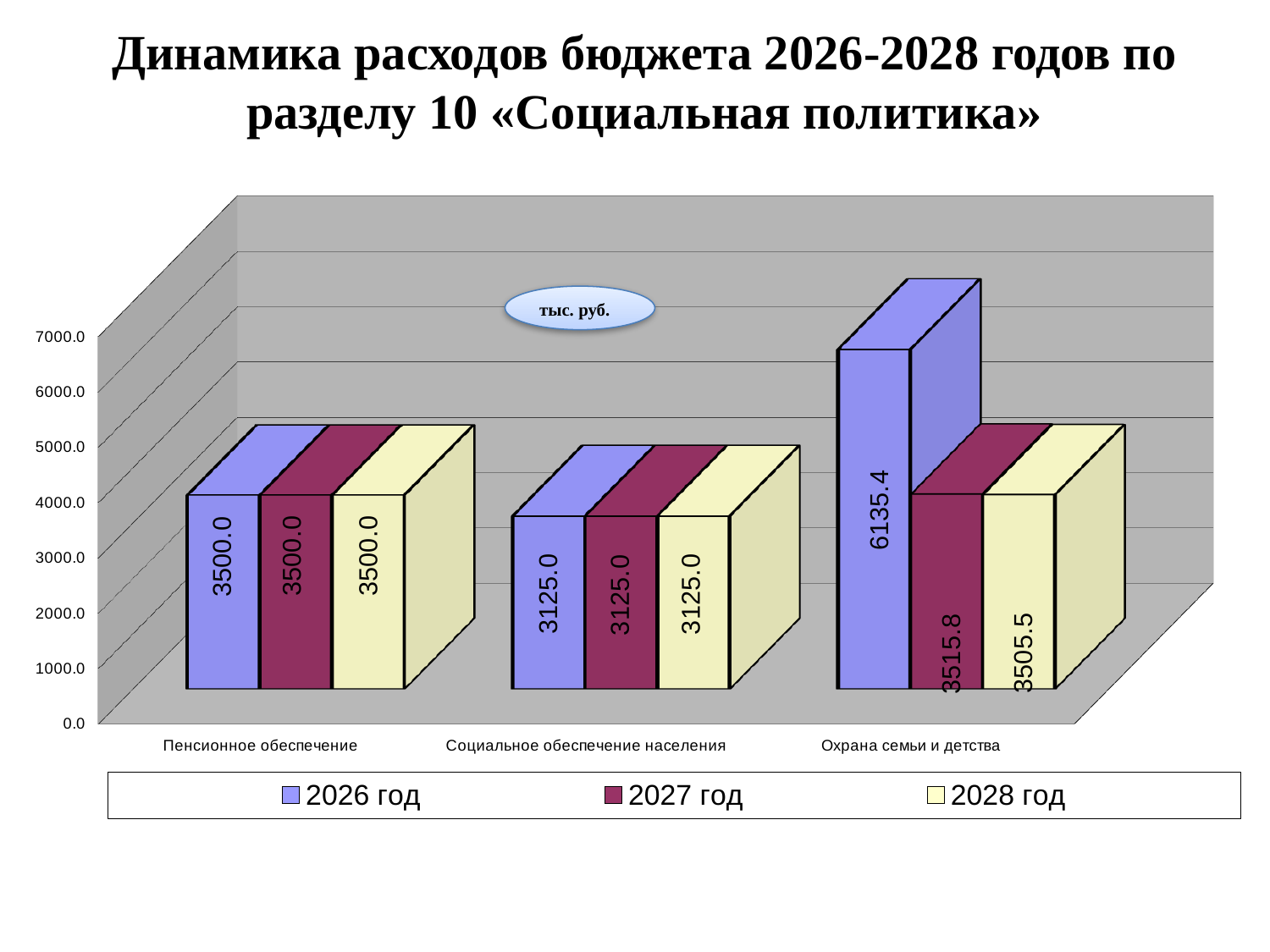
What is the value for Охрана семьи и детства in 2026 год? 6135.4 Is the value for Охрана семьи и детства in 2026 год greater or less than 6000? greater What is the value for Пенсионное обеспечение in 2027 год? 3500.0 What kind of chart is shown on the slide? bar chart How many categories are shown on the x axis? 3 How many series does the legend list? 3 Which is larger for 2028 год: Пенсионное обеспечение or Охрана семьи и детства? Охрана семьи и детства What is the difference between the 2026 год and 2027 год values for Охрана семьи и детства? 2619.6 Which category has the lowest value in 2027 год? Социальное обеспечение населения What is the value for Охрана семьи и детства in 2028 год? 3505.5 Which category has the highest value in 2026 год? Охрана семьи и детства What is the value for Социальное обеспечение населения in 2028 год? 3125.0